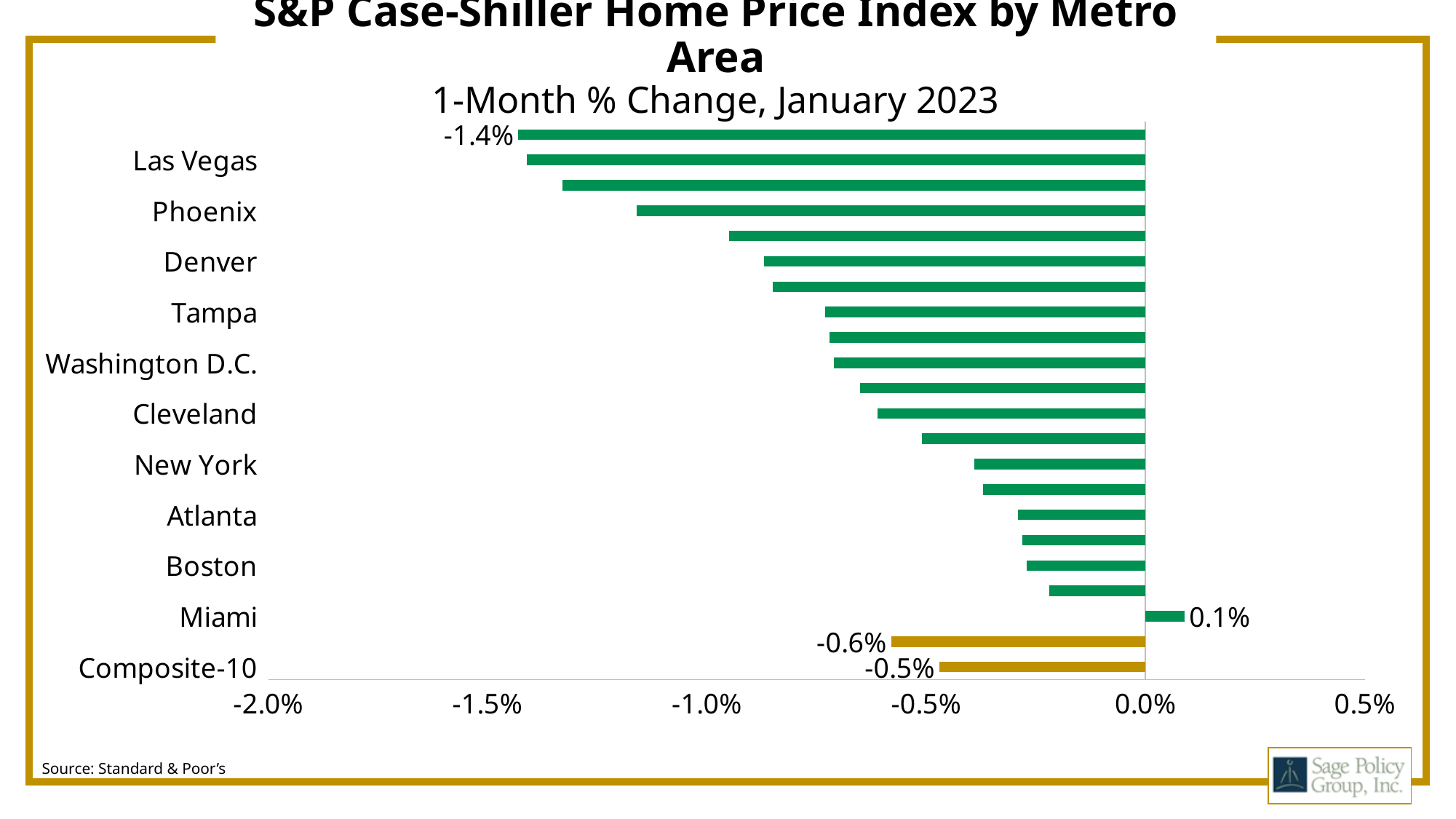
Is the value for Tampa greater or less than -0.5%? less Is the value for Las Vegas greater or less than -1.0%? less Which labeled metro area has the highest 1-month % change? Miami Is the value for Denver greater or less than -1.0%? greater What kind of chart is shown on the slide? bar chart What is the 1-month % change for Miami? 0.1% Which has the larger value, Miami or Composite-10? Miami What is the difference between the values for Miami (0.1%) and Composite-10 (-0.5%)? 0.6 percentage points What is the 1-month % change for Composite-10? -0.5% What is the subtitle of the chart? 1-Month % Change, January 2023 What is the lowest value printed as a data label on the chart? -1.4%